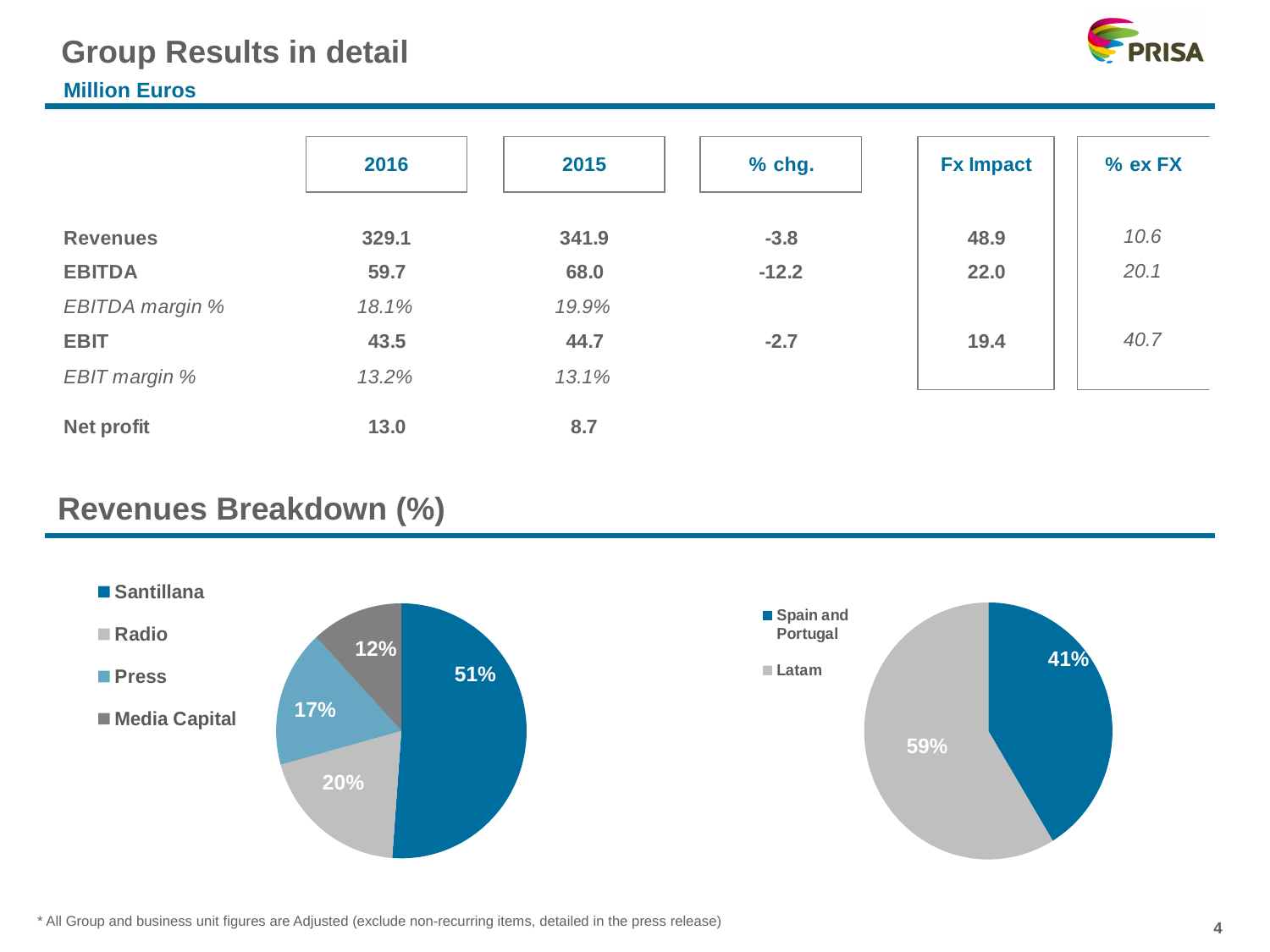
In the left pie chart under Revenues Breakdown, which business unit has the largest share? Santillana In the left pie chart under Revenues Breakdown, what share of revenues does Santillana account for? 51% In the left pie chart under Revenues Breakdown, what is the value for Press? 17% In the left pie chart under Revenues Breakdown, how many business units are shown? 4 In the left pie chart under Revenues Breakdown, which business unit has the smallest share? Media Capital In the left pie chart under Revenues Breakdown, what is the value for Radio? 20% In the left pie chart under Revenues Breakdown, what is the difference in percentage points between Santillana and Radio? 31 What kind of chart is used for the Revenues Breakdown on the slide? Pie chart In the right pie chart under Revenues Breakdown, what share of revenues comes from Spain and Portugal? 41% In the left pie chart under Revenues Breakdown, what is the value for Media Capital? 12% In the right pie chart under Revenues Breakdown, what share of revenues comes from Latam? 59% In the right pie chart under Revenues Breakdown, which region has the larger share, Spain and Portugal or Latam? Latam